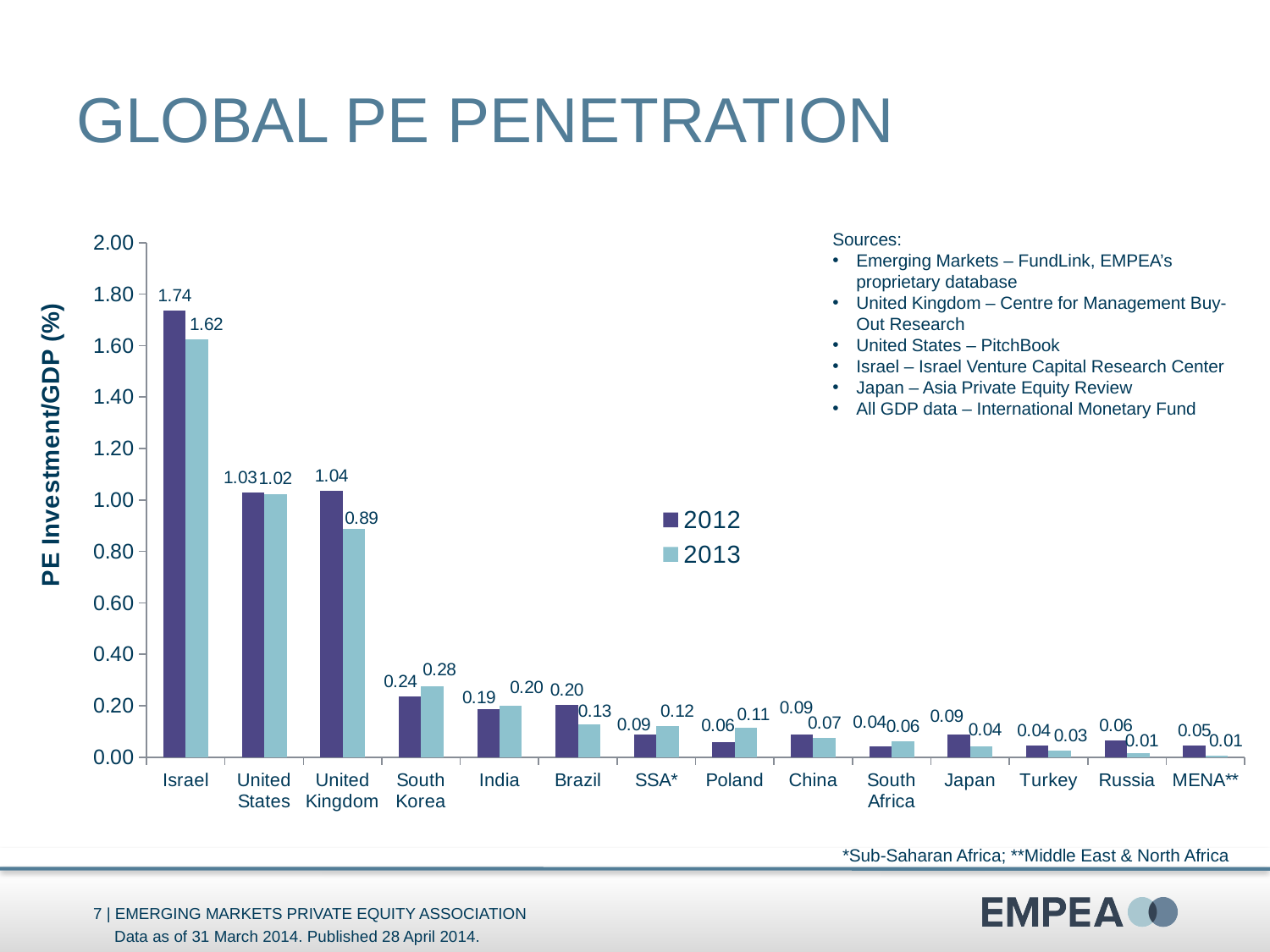
Which country has the highest 2013 PE Investment/GDP value? Israel What is the label of the y axis? PE Investment/GDP (%) What is the 2013 PE Investment/GDP value for the United Kingdom? 0.89 Which category has the lowest 2012 PE Investment/GDP value? South Africa and Turkey (0.04) Is the 2012 value for the United Kingdom greater or less than 1.00? greater How many series does the legend list? 2 What kind of chart is shown on the slide? Bar chart What is the difference between Israel's 2012 and 2013 values? 0.12 What is the 2013 value for Poland? 0.11 What is the 2012 PE Investment/GDP value for Israel? 1.74 Which is larger for South Korea: the 2012 value or the 2013 value? 2013 How many countries or regions are shown on the x axis? 14